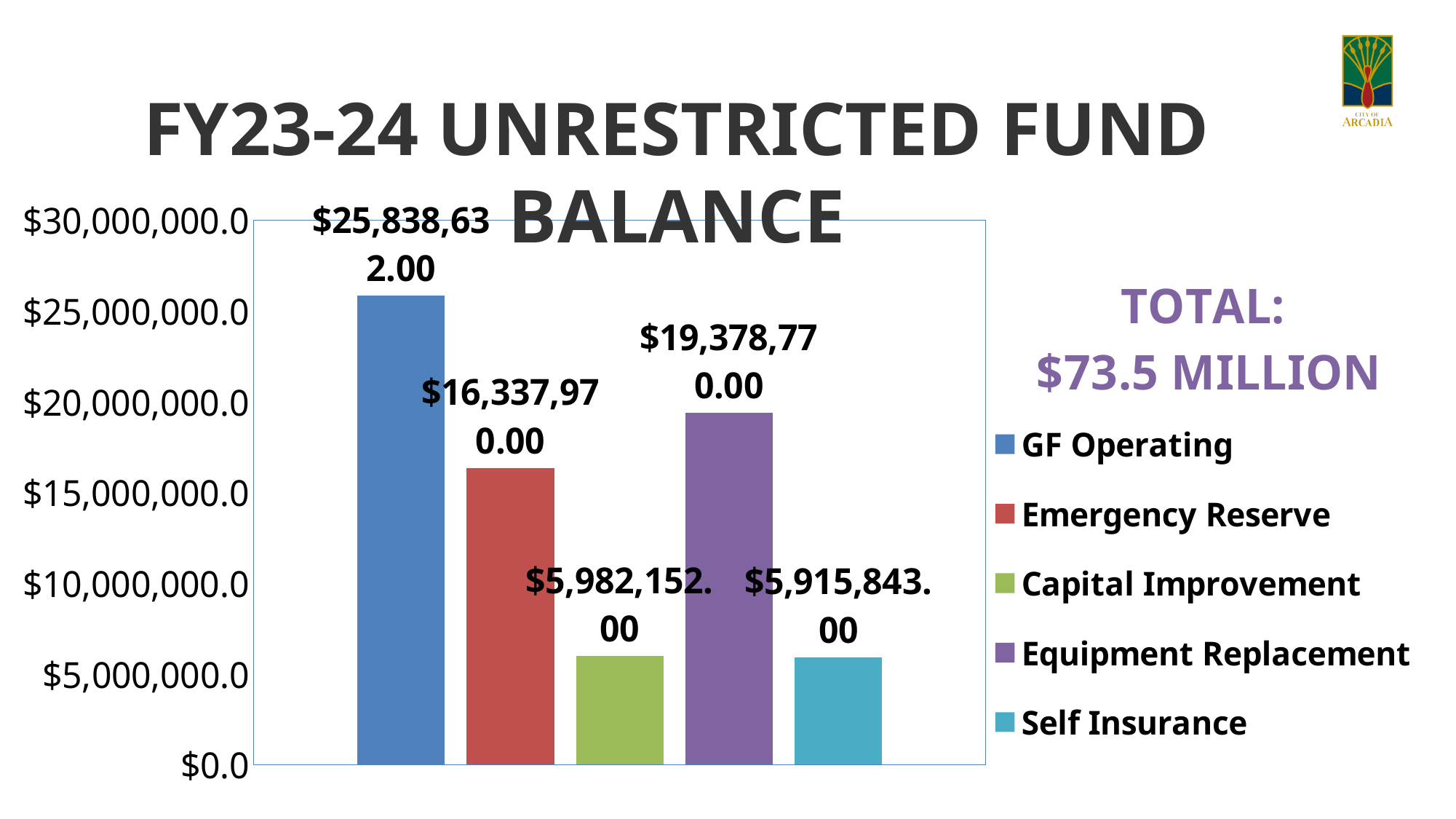
What is the value for Self Insurance? $5,915,843.00 What is the difference between GF Operating and Emergency Reserve? $9,500,662.00 Which category has the highest value? GF Operating What is the value for Equipment Replacement? $19,378,770.00 What is the value for Emergency Reserve? $16,337,970.00 What kind of chart is shown on the slide? bar chart What is the value for GF Operating? $25,838,632.00 What is the difference between Equipment Replacement and Emergency Reserve? $3,040,800.00 Is the value for Emergency Reserve greater or less than $15,000,000? greater Which is larger, Emergency Reserve or Equipment Replacement? Equipment Replacement What total is stated next to the chart? $73.5 MILLION How many bars are plotted in the chart? 5